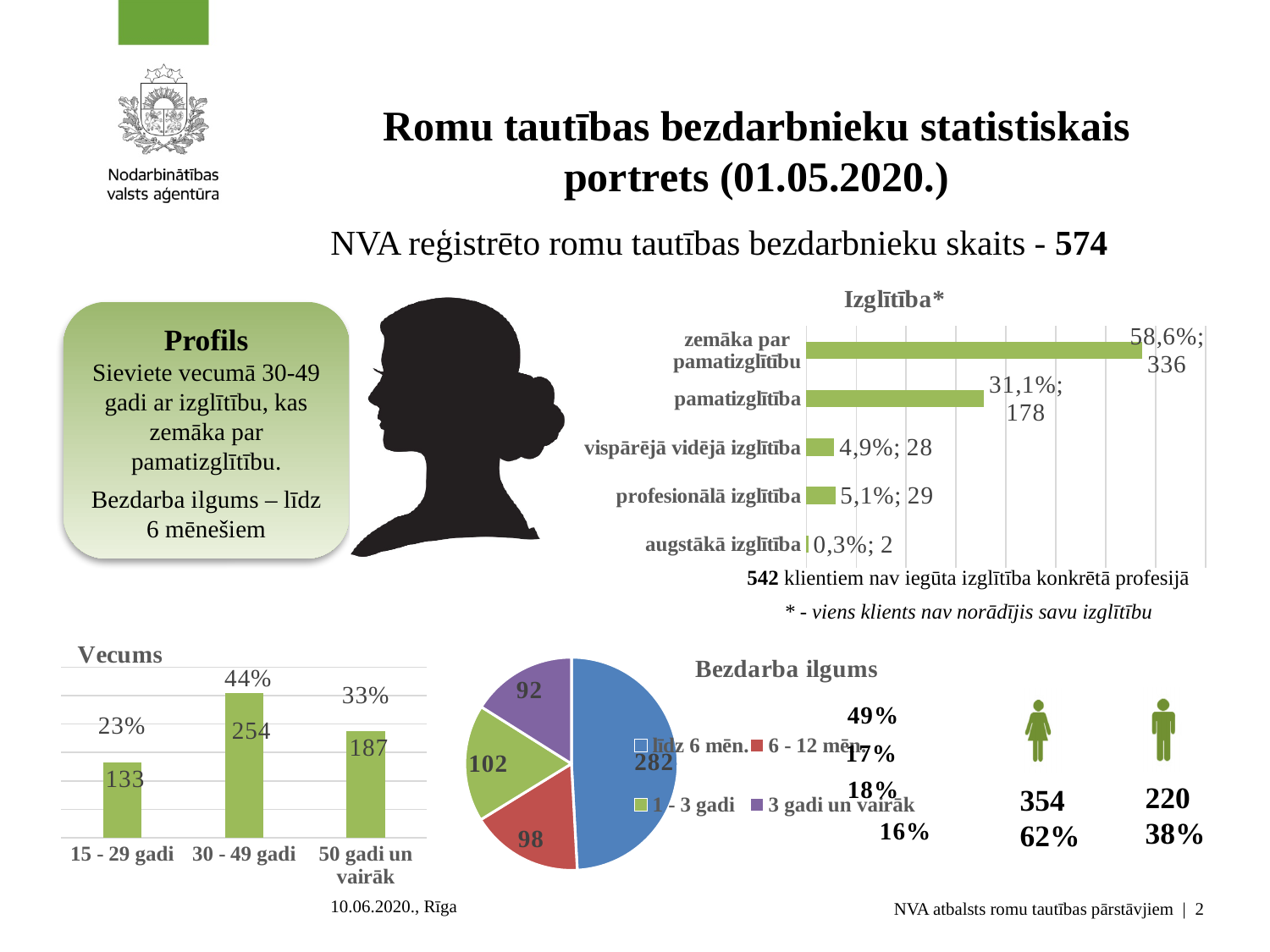
In the Vecums chart, which age group has the lowest value? 15 - 29 gadi In the Izglītība* chart, what is the value for pamatizglītība? 31,1%; 178 In the Bezdarba ilgums pie chart, how many series does the legend list? 4 In the Izglītība* chart, which category has the lowest value? augstākā izglītība What type of chart is the Izglītība* chart? bar chart In the Izglītība* chart, which category has the highest value? zemāka par pamatizglītību In the Izglītība* chart, how many categories are shown? 5 In the Vecums chart, which is larger: 15 - 29 gadi or 50 gadi un vairāk? 50 gadi un vairāk In the Vecums chart, what is the difference between the 30 - 49 gadi and 50 gadi un vairāk groups? 67 In the Vecums chart, what is the number of people aged 30 - 49 gadi? 254 In the Bezdarba ilgums pie chart, what is the value for the 6 - 12 mēn. slice? 98 In the Izglītība* chart, what is the difference in number of people between zemāka par pamatizglītību and pamatizglītība? 158